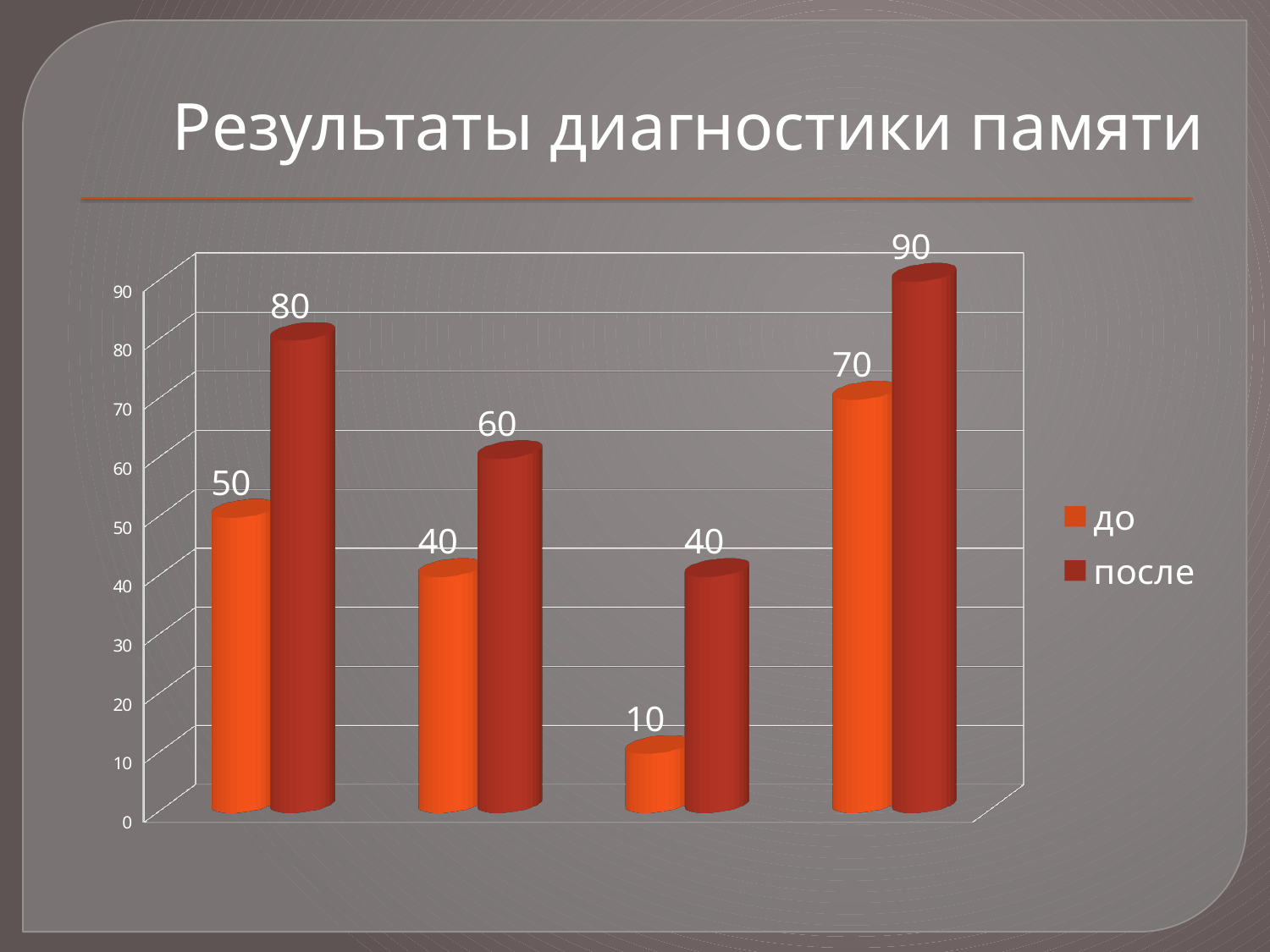
How many series does the legend list? 2 What is the difference between the "после" and "до" values in the third group of bars from the left? 30 In the second group of bars from the left, which is larger: the "до" value or the "после" value? после What kind of chart is shown on the slide? bar chart What is the value of the "до" series for the fourth group of bars from the left? 70 Which group of bars has the highest "после" value? the fourth group from the left Which legend entry is shown in the darker red colour? после How many groups of bars are plotted in the chart? 4 What is the value of the "после" series for the third group of bars from the left? 40 What is the title of the chart? Результаты диагностики памяти Which group of bars has the lowest "до" value? the third group from the left What is the value of the "до" series for the first group of bars from the left? 50